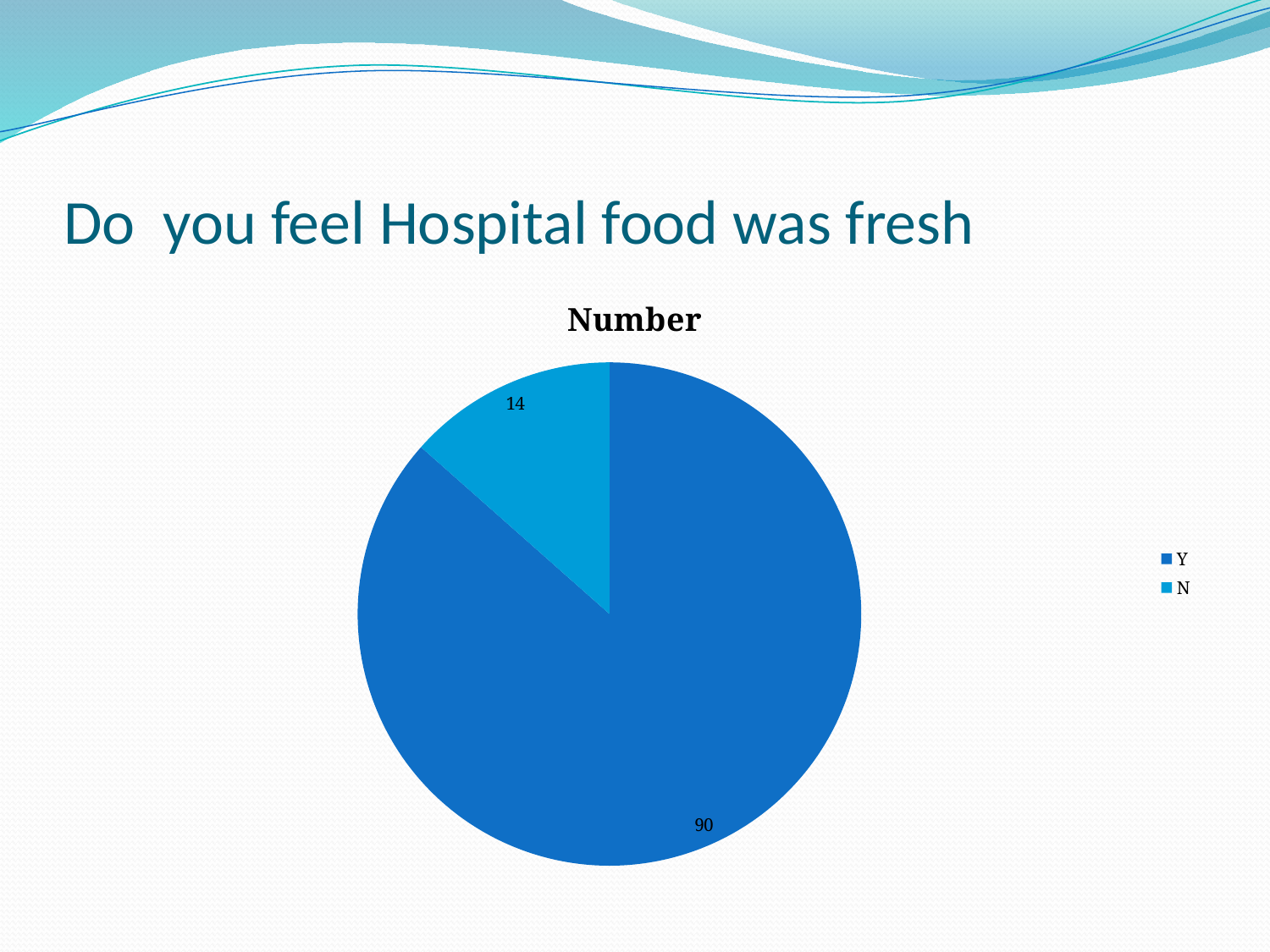
What is the title of the chart? Number What is the difference between the values for Y and N? 76 What is the value for Y? 90 What is the value for N? 14 How many slices does the pie chart have? 2 What type of chart is shown on the slide? pie chart Which category has the largest slice? Y What question does the slide title ask? Do you feel Hospital food was fresh How many entries does the legend list? 2 Which category has the smallest slice? N What is the total of all slices in the pie chart? 104 Which is larger, the value for Y or the value for N? Y